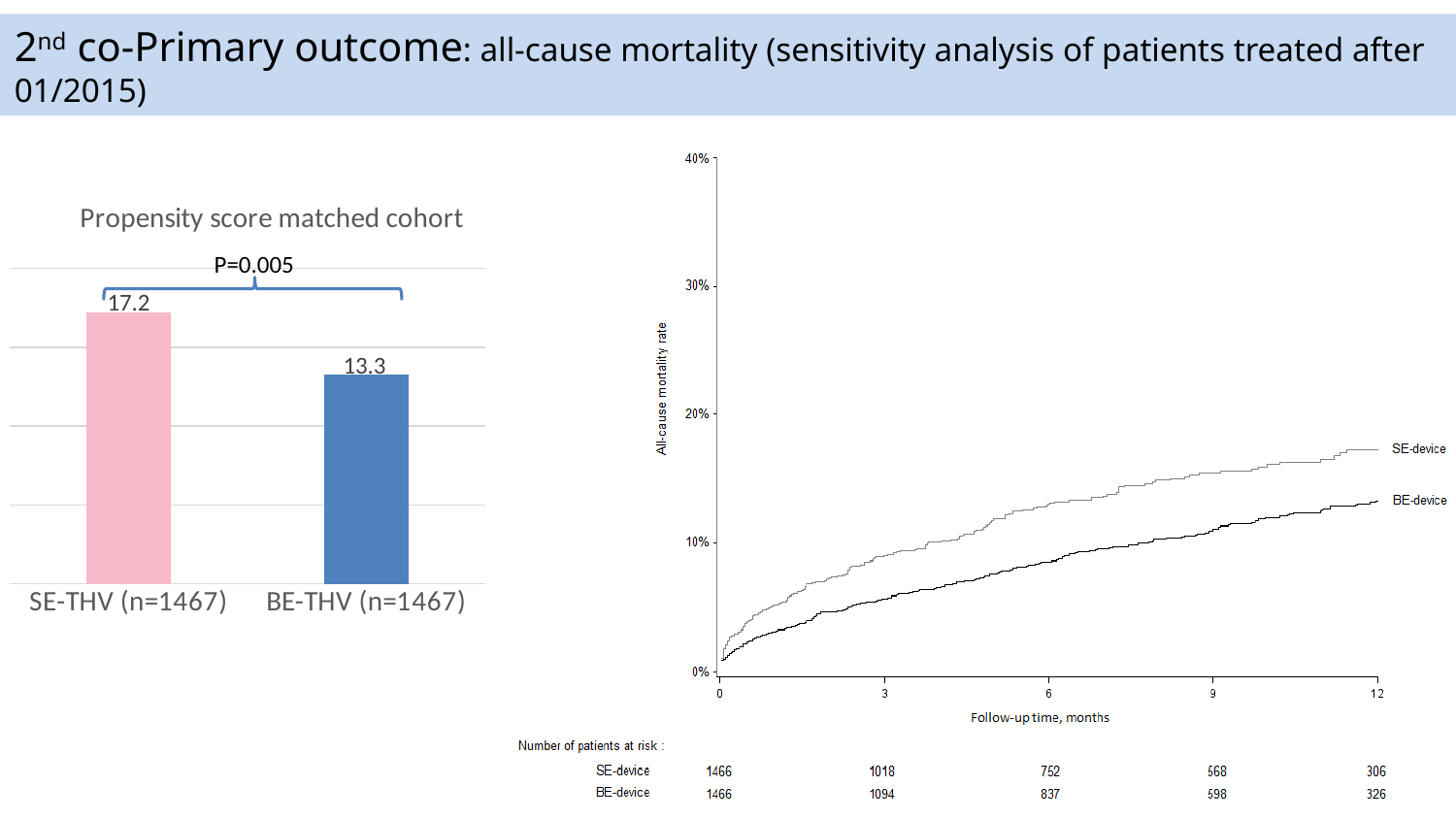
In the bar chart on the left, which category has the highest value? SE-THV (n=1467) In the line chart on the right, do the mortality curves rise or fall as follow-up time increases? rise In the bar chart on the left, what P value is shown above the bars? P=0.005 In the line chart on the right, which series has the higher all-cause mortality rate at 12 months, SE-device or BE-device? SE-device In the bar chart titled 'Propensity score matched cohort', what is the value for SE-THV (n=1467)? 17.2 In the bar chart on the left, how many bars are plotted? 2 In the line chart on the right, is the SE-device all-cause mortality rate at 12 months greater or less than 20%? less What kind of chart is the chart on the left of the slide? Bar chart What kind of chart is the chart on the right of the slide showing all-cause mortality rate over follow-up time? Line chart In the bar chart on the left, what is the difference between the SE-THV and BE-THV values? 3.9 In the bar chart titled 'Propensity score matched cohort', what is the value for BE-THV (n=1467)? 13.3 In the line chart on the right, how many series are labelled? 2